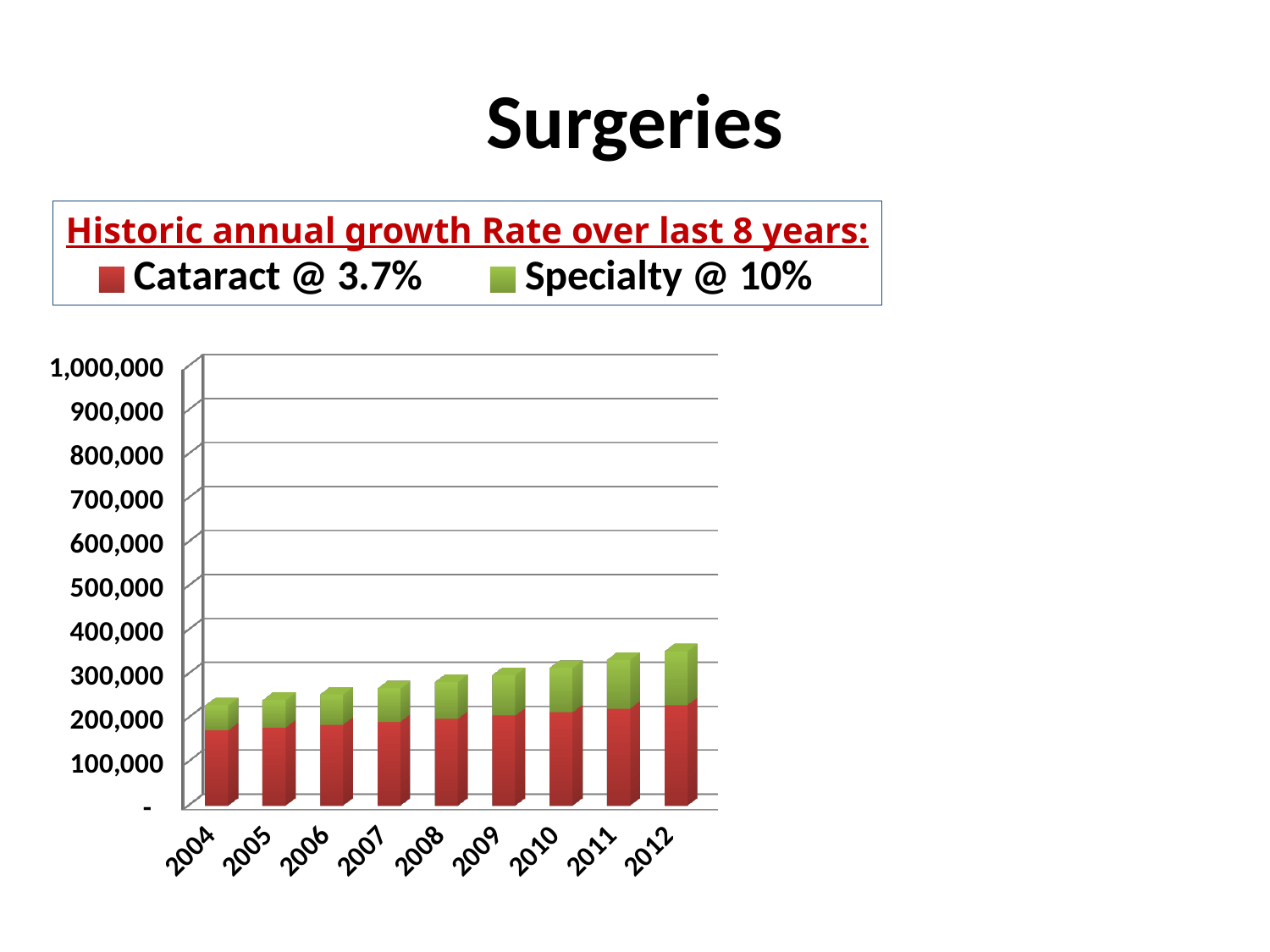
Do the total surgeries rise or fall from 2004 to 2012? Rise Is the total stacked bar for 2004 greater or less than 300,000? less What kind of chart is shown on the slide? Stacked bar chart Is the Cataract value for 2004 greater or less than 200,000? less Is the total stacked bar for 2012 greater or less than 300,000? greater Which year has the tallest stacked bar in the chart? 2012 What historic annual growth rate is stated for Cataract surgeries? 3.7% Which colour represents the Specialty series in the chart? Green How many series does the chart's legend list? 2 Which year has the shortest stacked bar in the chart? 2004 How many years are shown on the x axis of the chart? 9